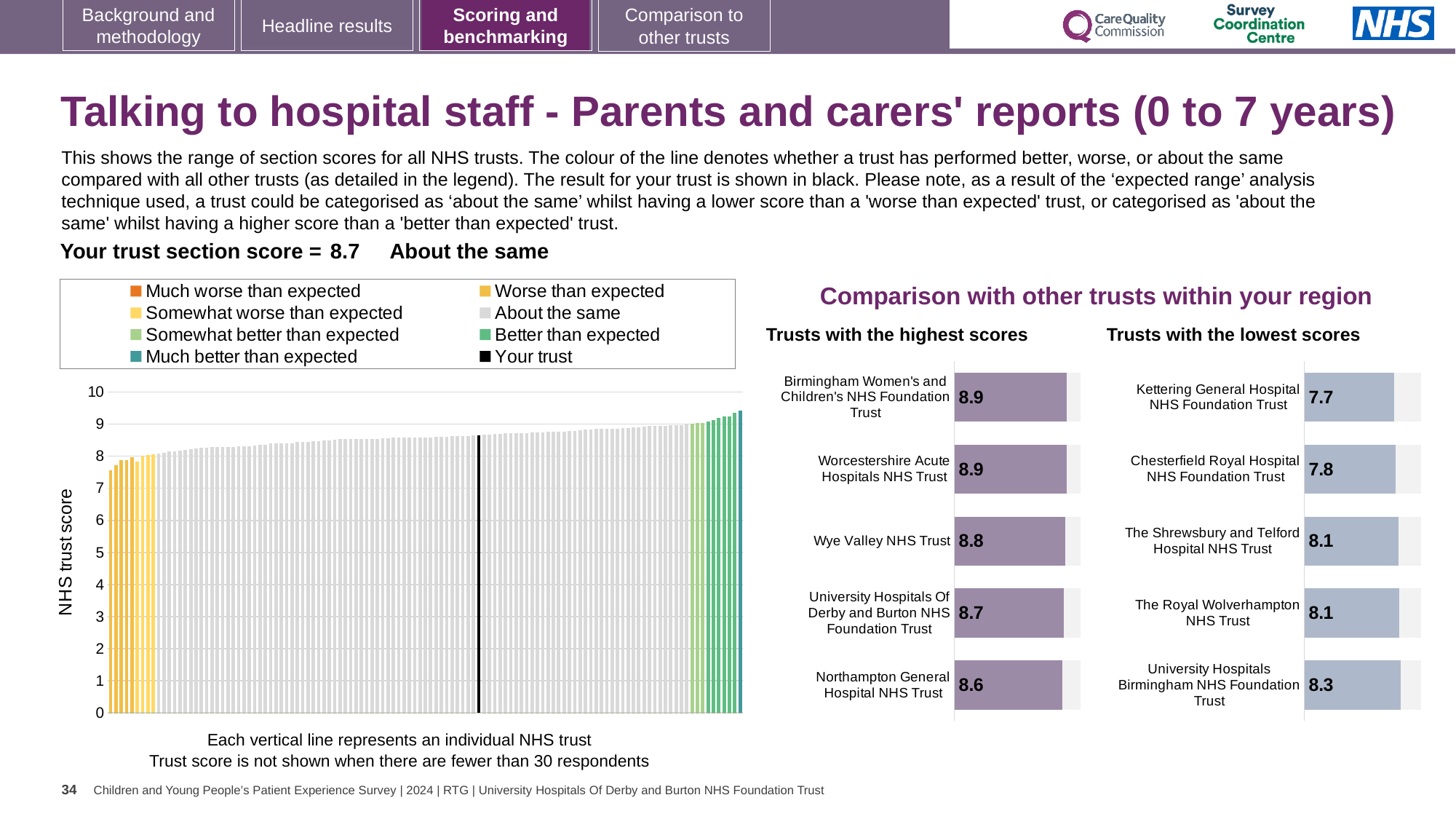
In the 'Trusts with the lowest scores' chart, which trust has the highest score? University Hospitals Birmingham NHS Foundation Trust Which has the higher score: Wye Valley NHS Trust in the highest scores chart or Chesterfield Royal Hospital NHS Foundation Trust in the lowest scores chart? Wye Valley NHS Trust How many entries does the legend of the large chart on the left list? 8 In the 'Trusts with the lowest scores' chart, which trust has the lowest score? Kettering General Hospital NHS Foundation Trust In the large chart on the left, do the trust scores rise or fall from left to right? rise In the 'Trusts with the highest scores' chart, what is the score for Wye Valley NHS Trust? 8.8 In the 'Trusts with the lowest scores' chart, what is the difference between the scores of University Hospitals Birmingham NHS Foundation Trust and Kettering General Hospital NHS Foundation Trust? 0.6 In the 'Trusts with the lowest scores' chart, what is the score for Chesterfield Royal Hospital NHS Foundation Trust? 7.8 In the large chart on the left, is the value for the black 'Your trust' line greater or less than 8? greater How many trusts are listed in the 'Trusts with the highest scores' chart? 5 In the 'Trusts with the highest scores' chart, what is the difference between the scores of Birmingham Women's and Children's NHS Foundation Trust and Northampton General Hospital NHS Trust? 0.3 In the 'Trusts with the highest scores' chart, which trust has the lowest score? Northampton General Hospital NHS Trust